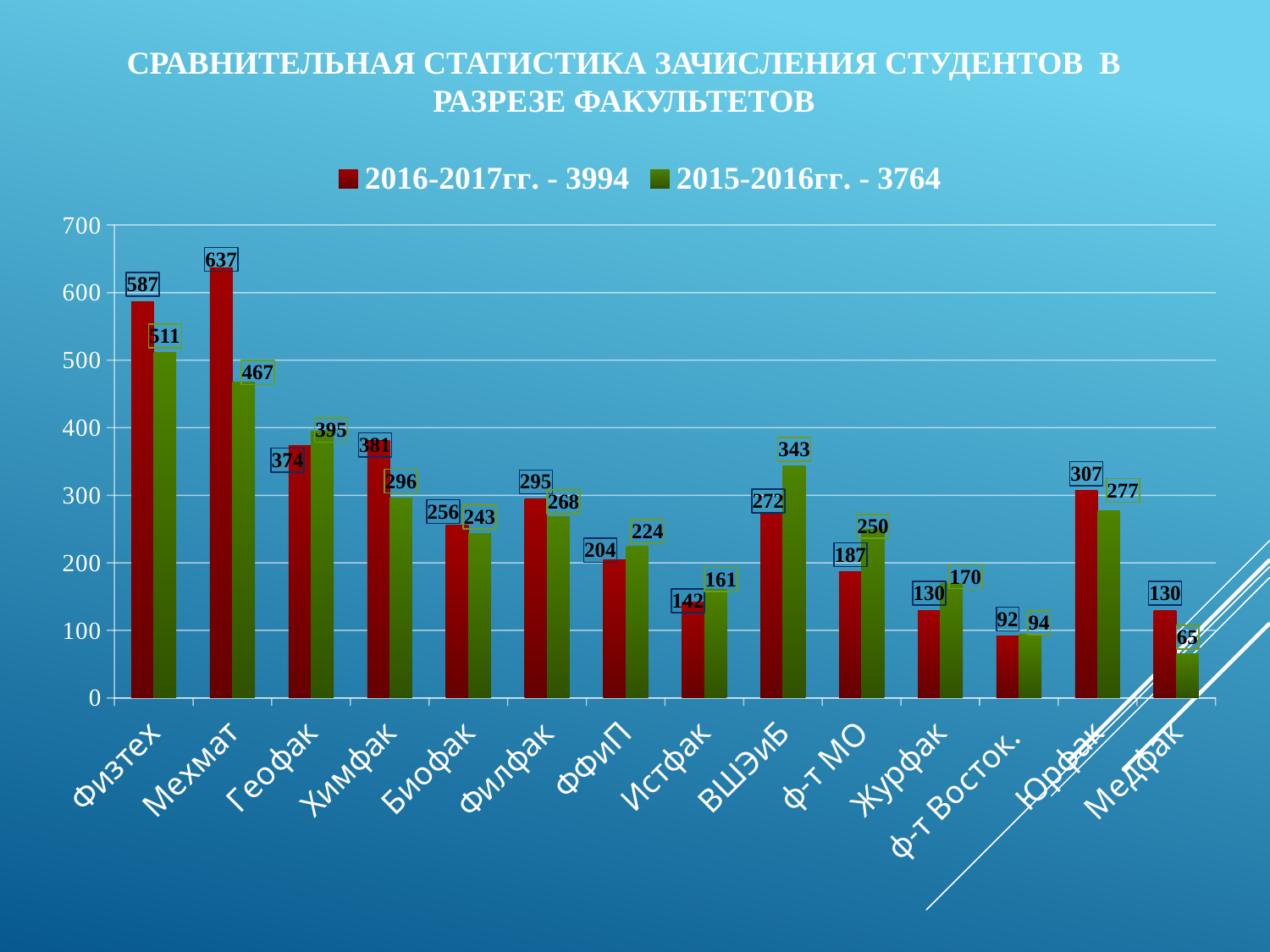
What is the value for Мехмат in the 2016-2017гг. series? 637 What is the difference between the 2016-2017гг. and 2015-2016гг. values for Физтех? 76 What total is shown in the legend entry for the 2016-2017гг. series? 3994 What is the value for Медфак in the 2015-2016гг. series? 65 Which faculty has the highest value in the 2016-2017гг. series? Мехмат Which faculty has the lowest value in the 2015-2016гг. series? Медфак What is the value for ВШЭиБ in the 2015-2016гг. series? 343 For Геофак, which series has the larger value: 2016-2017гг. or 2015-2016гг.? 2015-2016гг. How many faculties (categories) are shown on the x axis? 14 What type of chart is shown on the slide? bar chart How many series does the legend list? 2 What is the difference between the 2015-2016гг. and 2016-2017гг. values for ф-т МО? 63